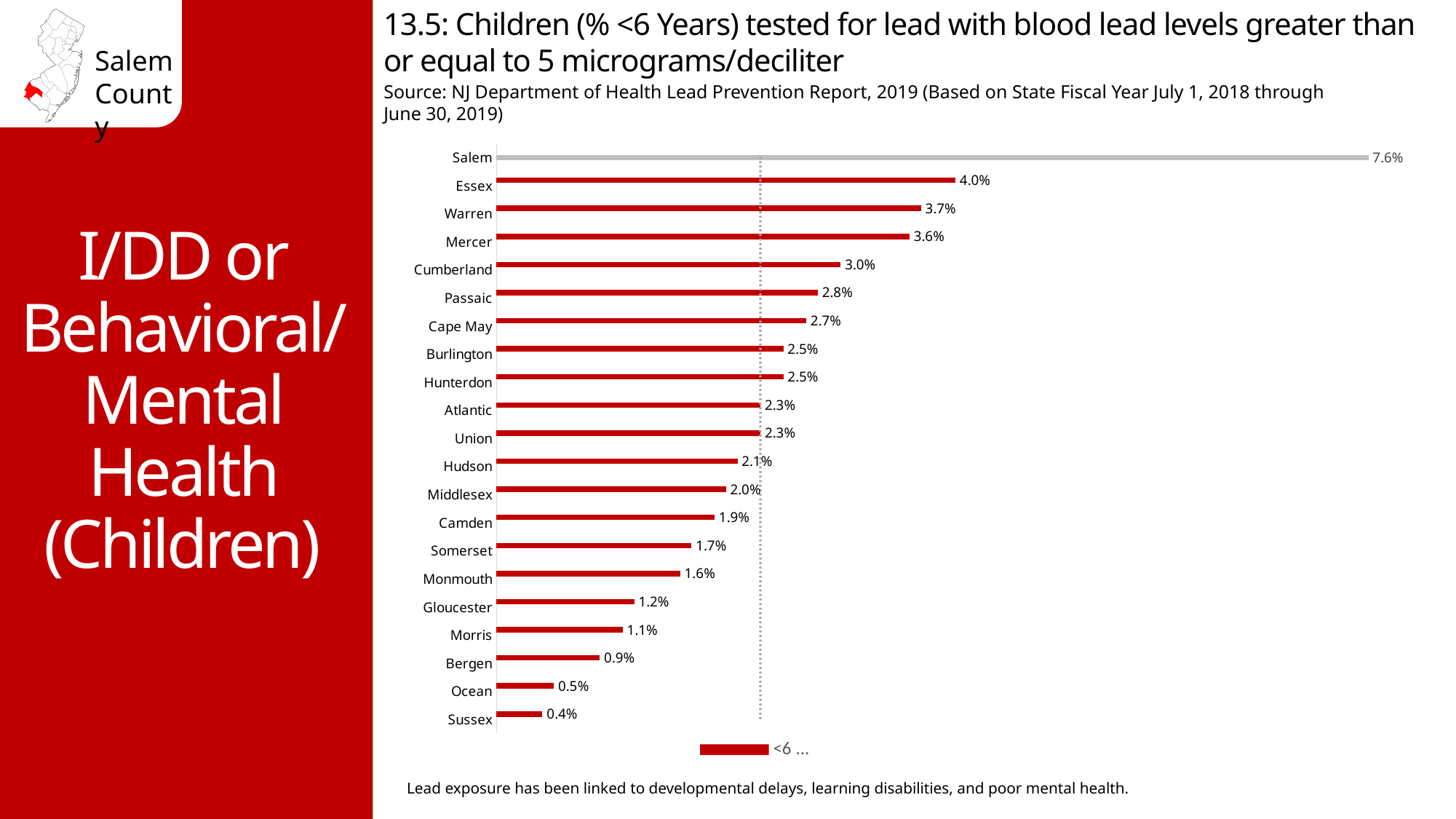
Which is larger, the value for Bergen or the value for Monmouth? Monmouth Which is larger, the value for Warren or the value for Passaic? Warren What is the difference between the values for Salem and Essex? 3.6% What is the value for Gloucester? 1.2% What is the value for Salem? 7.6% What is the difference between the values for Mercer and Camden? 1.7% How many counties are shown in the chart? 21 Which county has the lowest value? Sussex What kind of chart is shown on the slide? Bar chart What is the value for Cumberland? 3.0% What colour is the bar for Salem? Gray Which county has the highest value? Salem